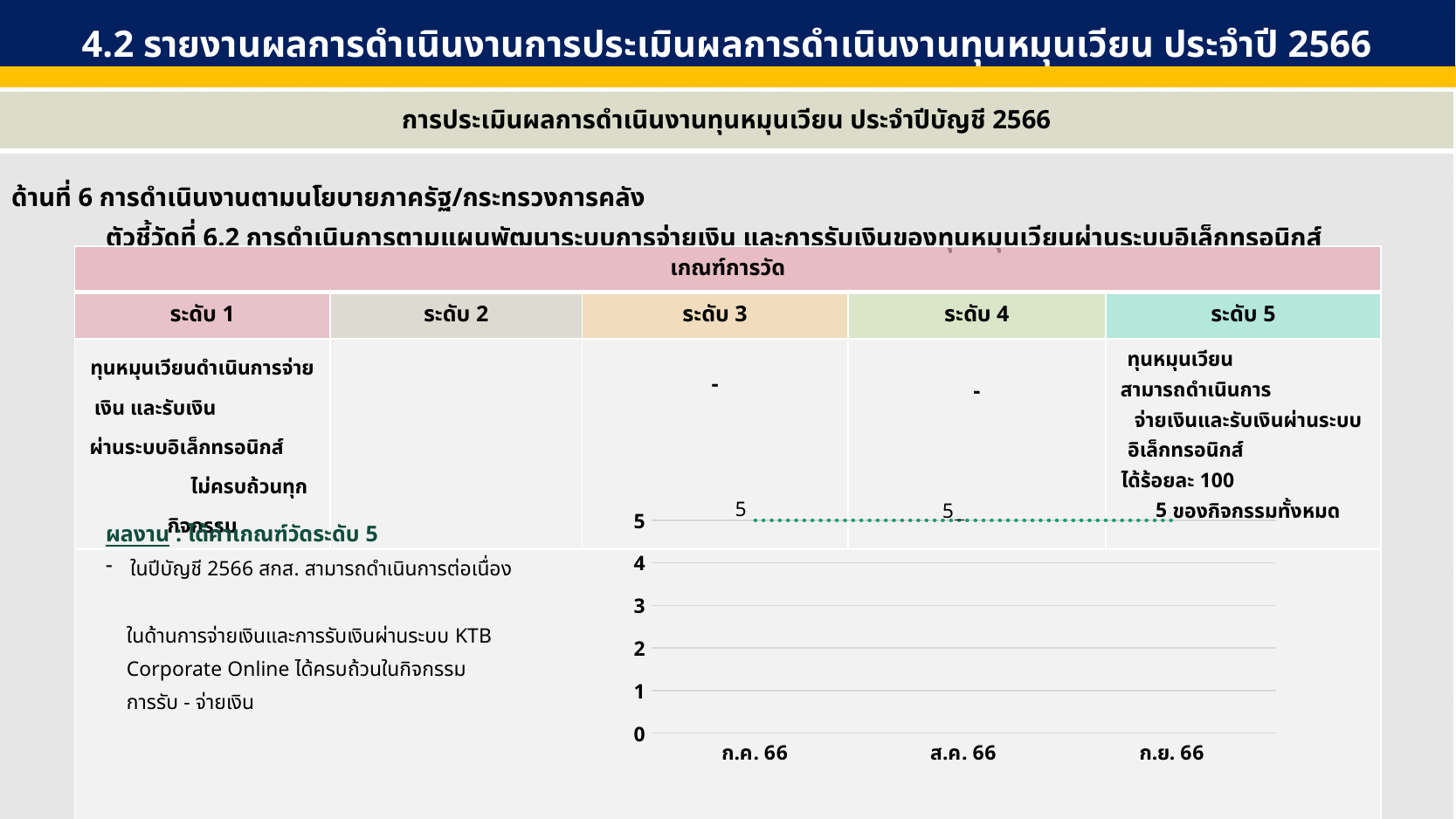
What is the label of the first category on the x axis of the chart? ก.ค. 66 What is the value plotted for ก.ย. 66? 5 Is the value for ส.ค. 66 greater or less than 3? greater What is the difference between the values for ก.ค. 66 and ก.ย. 66? 0 What type of chart is shown at the bottom of the slide? line chart Do the plotted values rise, fall, or stay flat from ก.ค. 66 to ก.ย. 66? stay flat What is the highest value shown on the vertical axis of the chart? 5 What is the value plotted for ก.ค. 66? 5 What is the value plotted for ส.ค. 66? 5